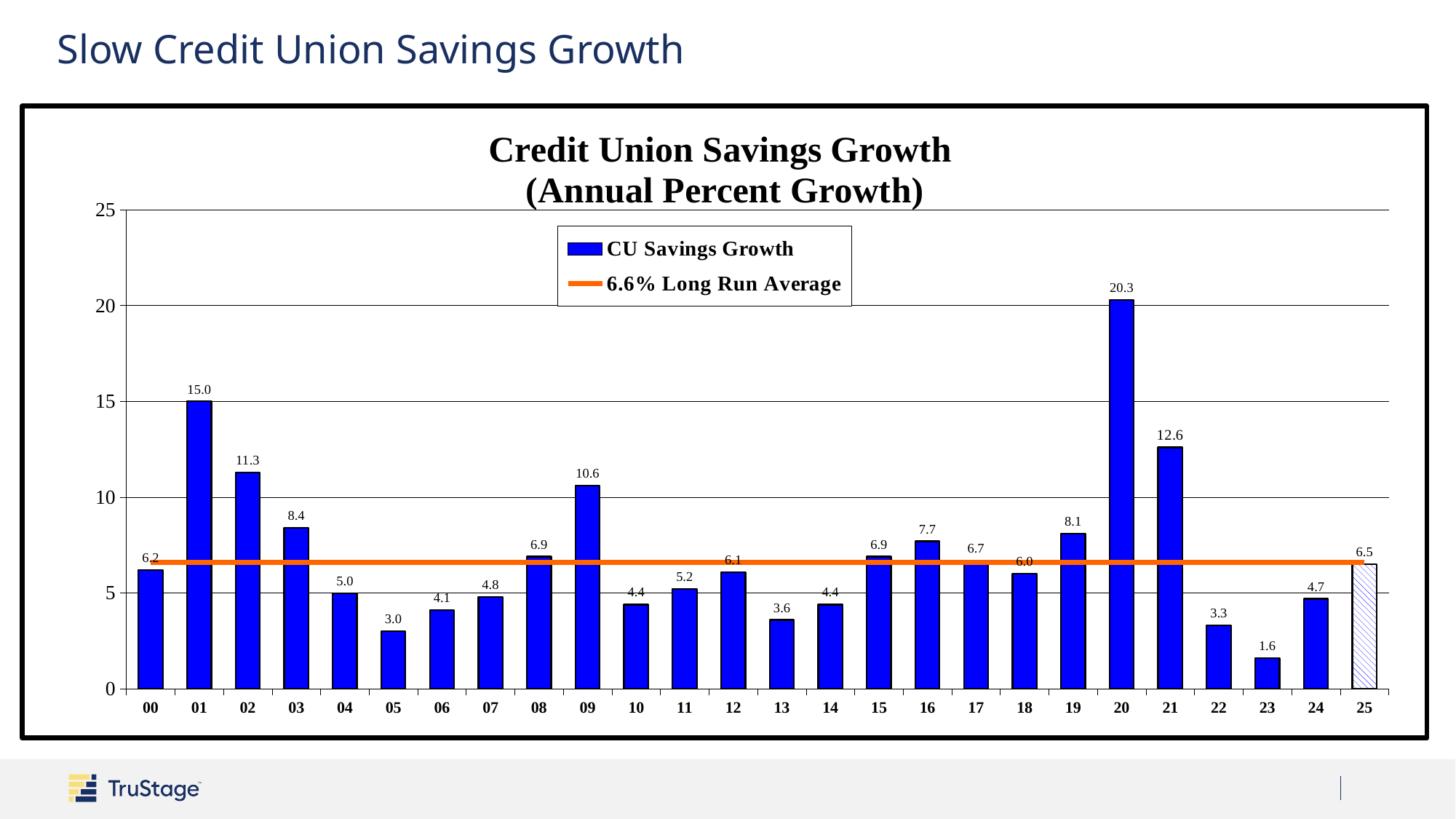
What value does the long run average line represent according to the legend? 6.6% What kind of chart is this? bar chart Which is larger, the CU Savings Growth value for 01 or for 02? 01 What is the CU Savings Growth value for 23? 1.6 Which year has the lowest CU Savings Growth? 23 How many series does the legend list? 2 What is the difference between the CU Savings Growth values for 20 and 21? 7.7 What is the CU Savings Growth value for 20? 20.3 Is the CU Savings Growth value for 19 greater or less than 10? less Which year has the highest CU Savings Growth? 20 What is the CU Savings Growth value for 09? 10.6 How many years are shown on the x axis? 26